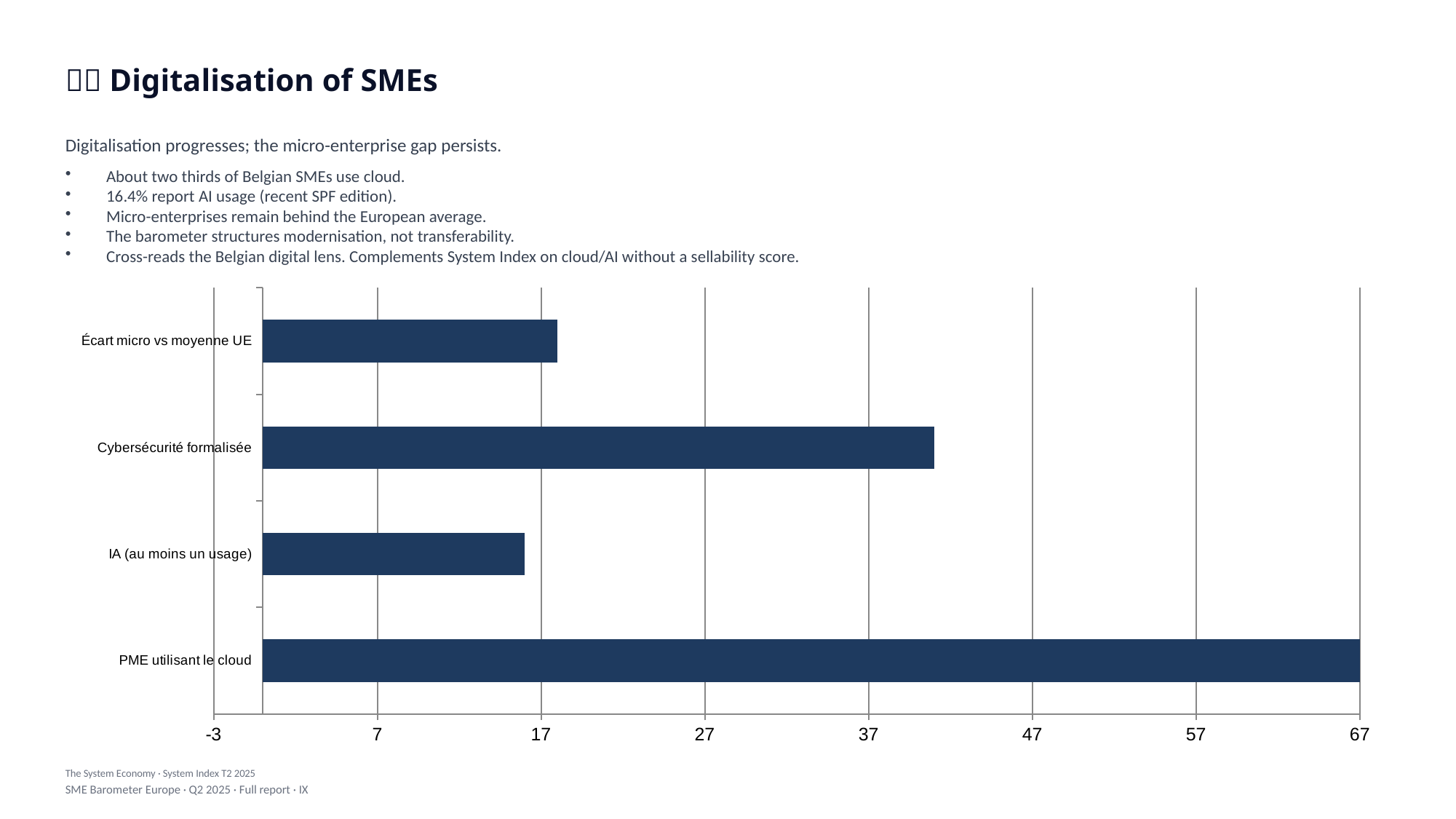
What is the value for PME utilisant le cloud? 67 Which is larger: the value for PME utilisant le cloud or the value for Cybersécurité formalisée? PME utilisant le cloud Which is larger: the value for Cybersécurité formalisée or the value for Écart micro vs moyenne UE? Cybersécurité formalisée Which category has the lowest value in the chart? IA (au moins un usage) Is the value for IA (au moins un usage) greater or less than 17? less How many categories are plotted in the chart? 4 What is the lowest tick value shown on the horizontal axis of the chart? -3 Is the value for Cybersécurité formalisée greater or less than 37? greater Is the value for Cybersécurité formalisée greater or less than 47? less What kind of chart is shown on the slide? bar chart Which category has the highest value in the chart? PME utilisant le cloud